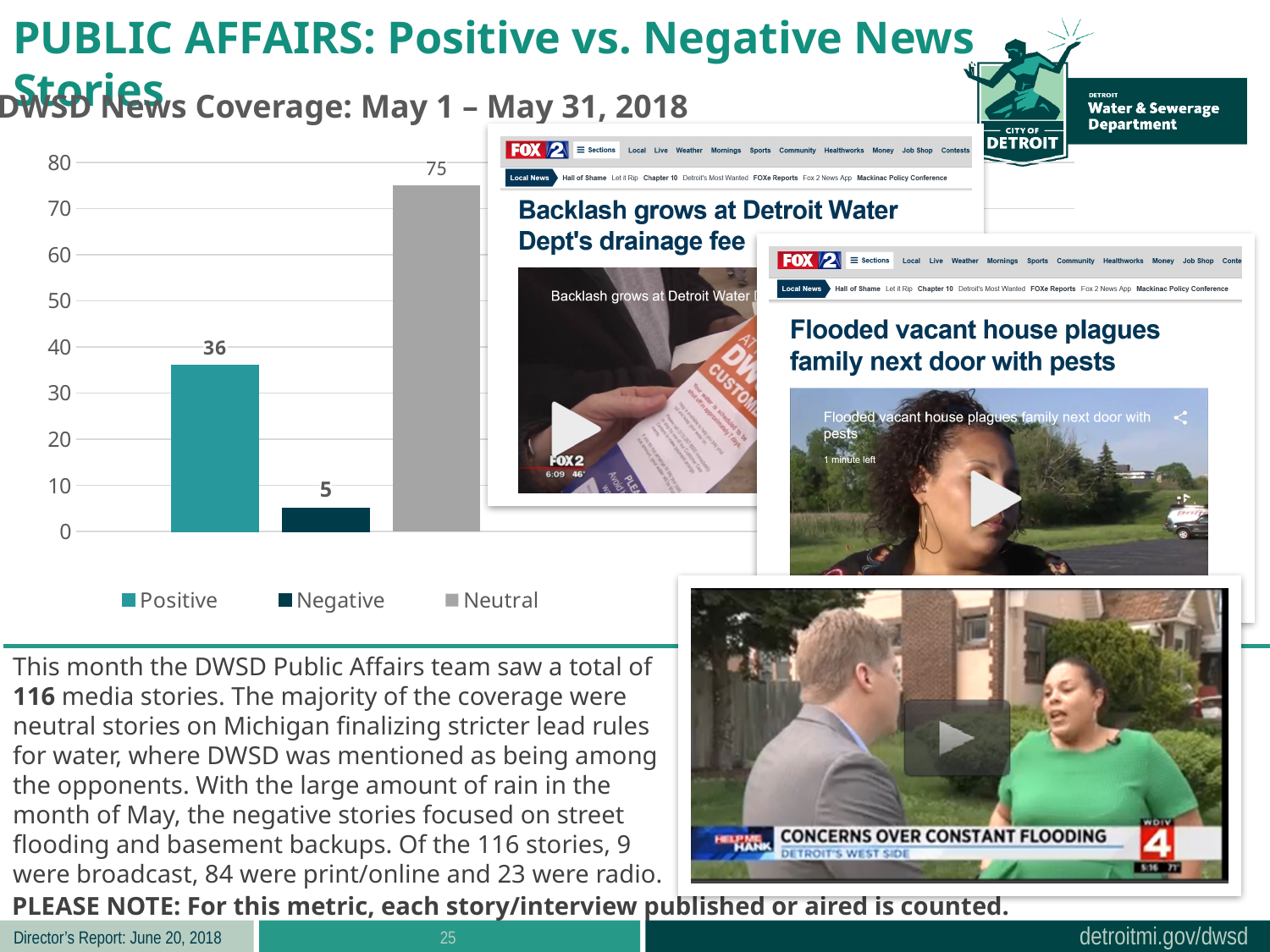
What is the value for Neutral stories in the DWSD News Coverage chart? 75 What is the value for Positive stories in the DWSD News Coverage chart? 36 What is the value for Negative stories in the DWSD News Coverage chart? 5 What is the difference between the Neutral and Positive values in the DWSD News Coverage chart? 39 Which is larger in the DWSD News Coverage chart, Positive or Negative? Positive Is the value for Neutral greater or less than 70 in the DWSD News Coverage chart? greater How many categories are shown in the DWSD News Coverage chart? 3 What kind of chart is the DWSD News Coverage chart? bar chart What is the difference between the Positive and Negative values in the DWSD News Coverage chart? 31 What entries does the legend of the DWSD News Coverage chart list? Positive, Negative, Neutral Which category has the highest value in the DWSD News Coverage chart? Neutral Which category has the lowest value in the DWSD News Coverage chart? Negative